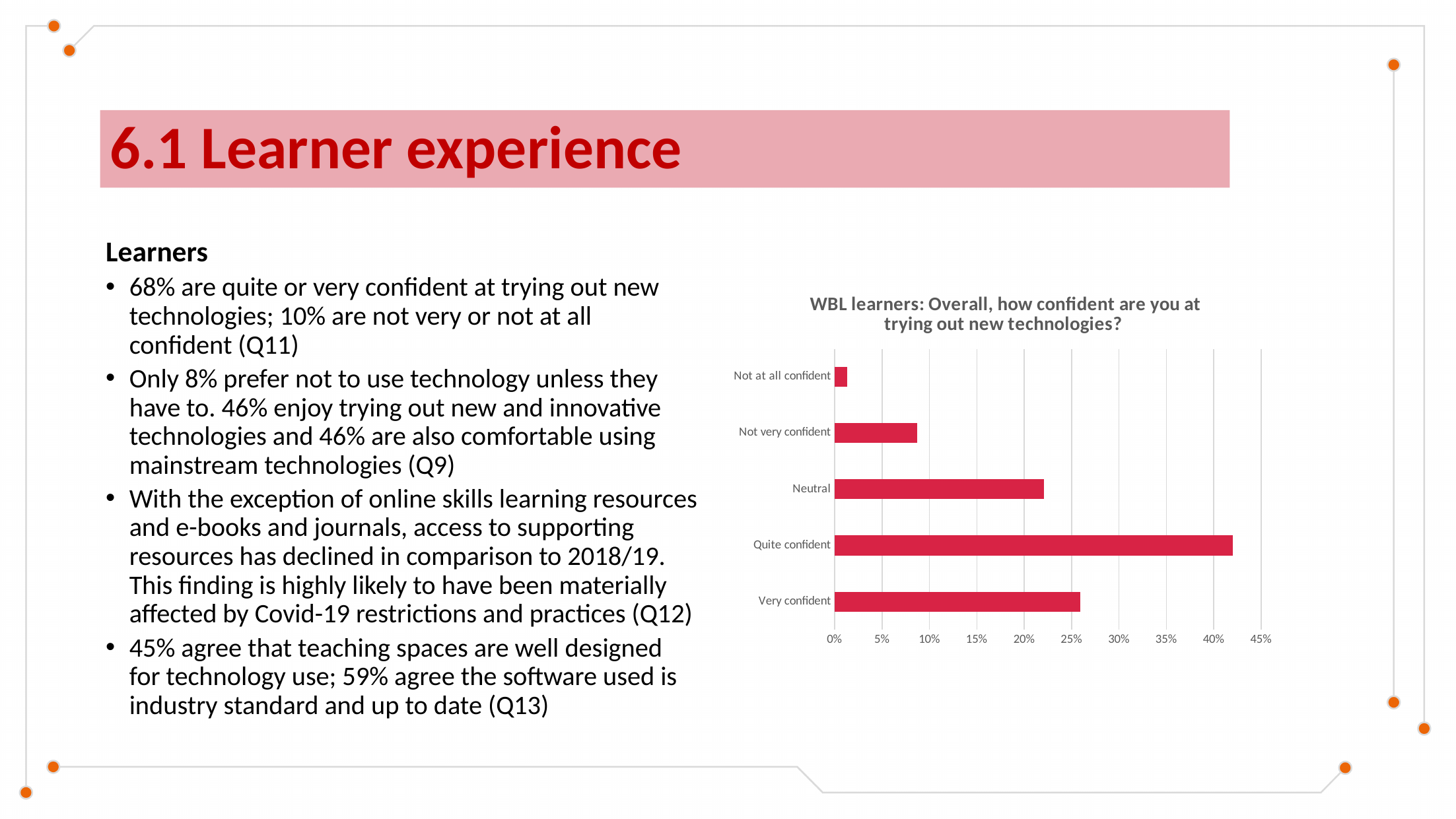
Which is larger, the value for Not very confident or the value for Neutral? Neutral Is the value for Quite confident greater or less than 35%? greater Is the value for Neutral greater or less than 25%? less Is the value for Not at all confident greater or less than 5%? less Which category has the highest value in the chart? Quite confident Which is larger, the value for Very confident or the value for Neutral? Very confident How many categories are plotted in the chart? 5 What kind of chart is shown on the slide? bar chart What is the title of the chart? WBL learners: Overall, how confident are you at trying out new technologies? Which category has the lowest value in the chart? Not at all confident